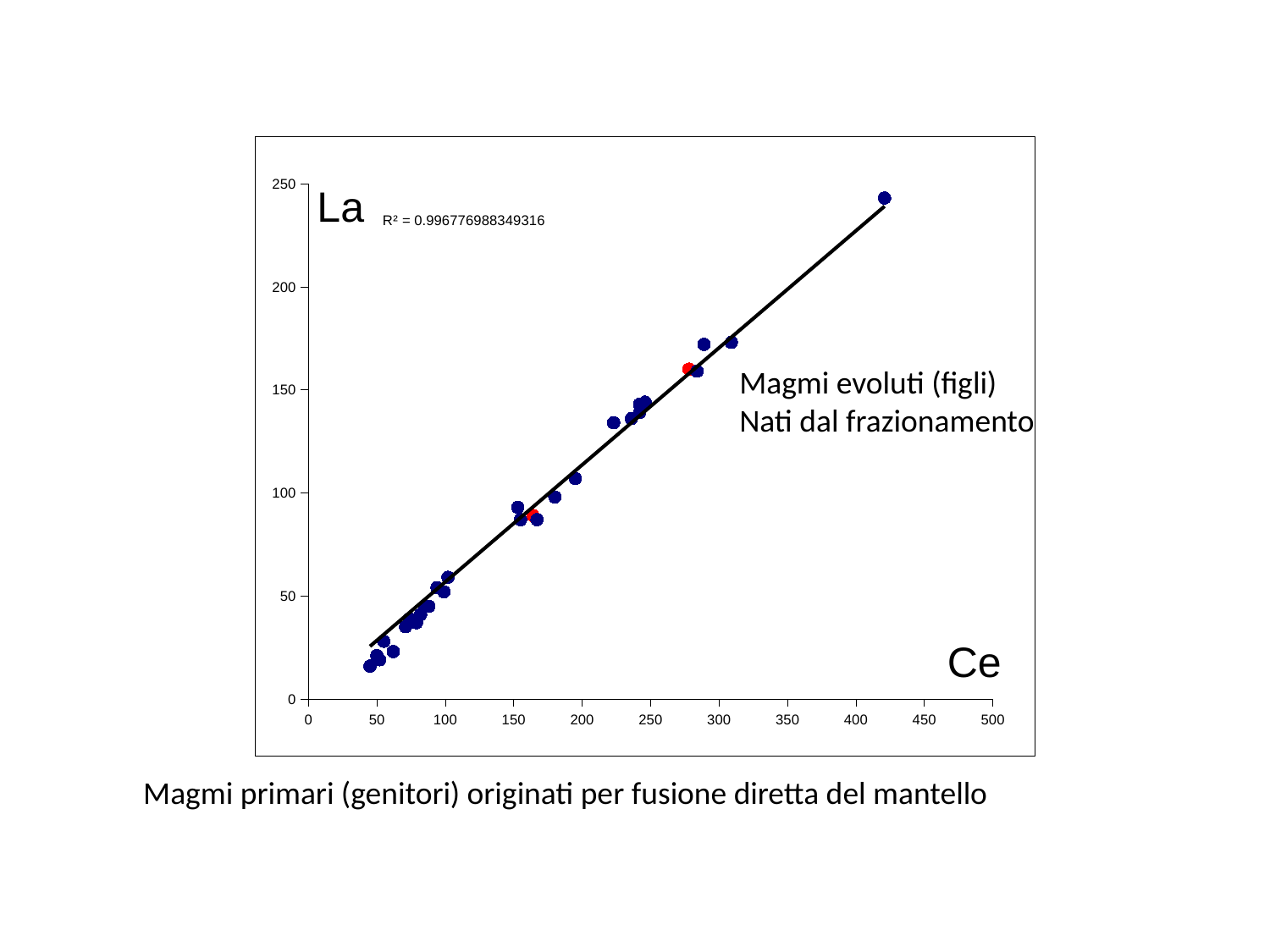
Is the La value of the red point located near Ce = 280 greater or less than 150? greater What label is shown on the y axis of the chart? La Which point has the higher La value: the point near Ce = 420 or the point near Ce = 310? the point near Ce = 420 As Ce increases along the x axis, do the La values rise or fall? rise What R² value is printed on the chart? R² = 0.996776988349316 Is the Ce value of the highest point on the chart greater or less than 400? greater What is the maximum value shown on the x axis? 500 What kind of chart is shown on the slide? scatter plot Is the La value of the point with the highest Ce value greater or less than 200? greater What is the maximum value shown on the y axis? 250